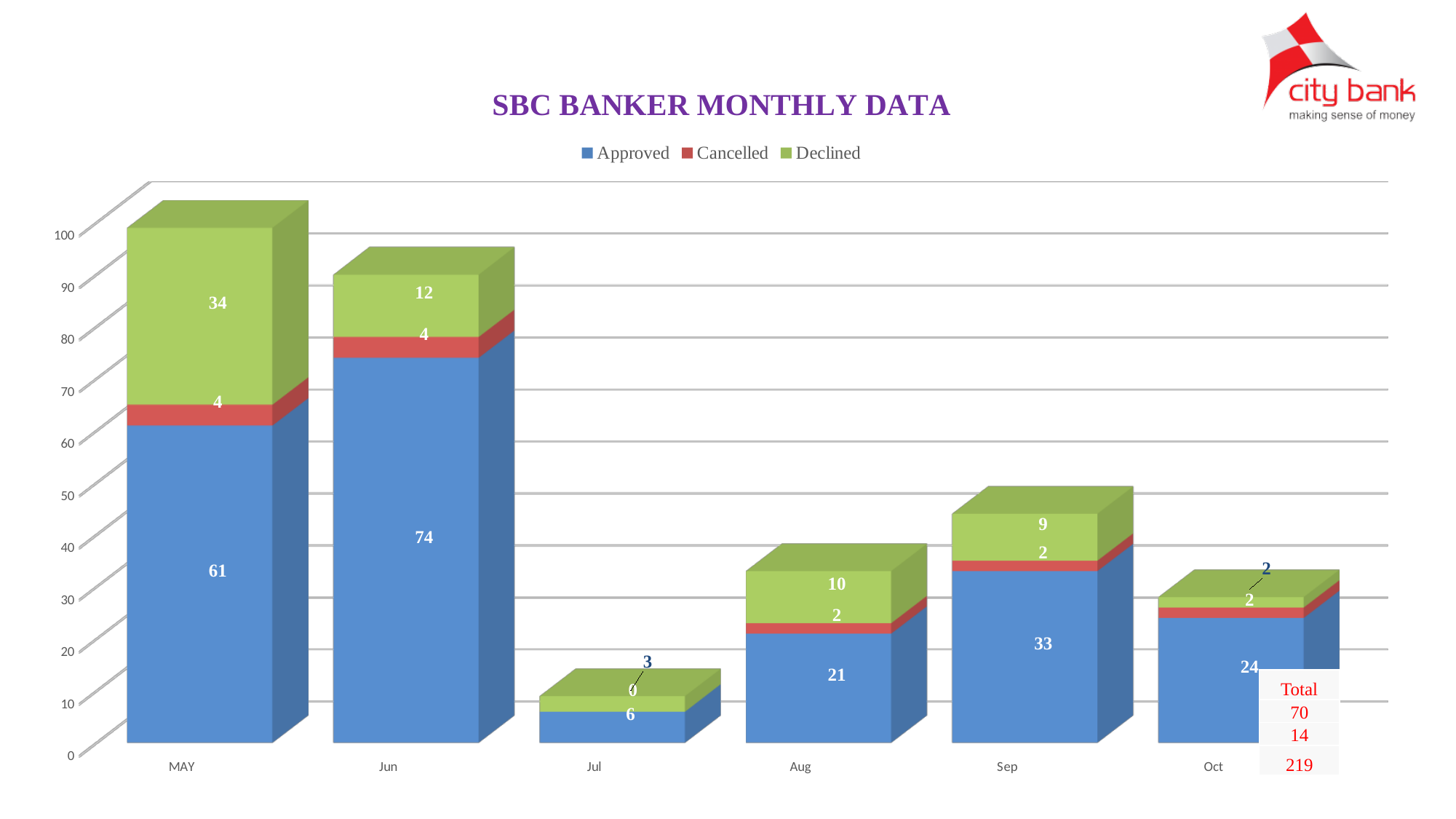
What is the Cancelled value for Jul? 0 What is the Approved value for Jun? 74 What is the difference between the Approved values for Sep and Aug? 12 How many series does the legend list? 3 What is the total of the stacked bar for MAY? 99 What is the Declined value for MAY? 34 What kind of chart is shown on the slide? Stacked bar chart Which is larger, the Declined value for Aug or the Declined value for Sep? Aug How many months are shown on the x axis? 6 Which month has the lowest Declined value? Oct What is the total of the stacked bar for Aug? 33 Which month has the highest Approved value? Jun